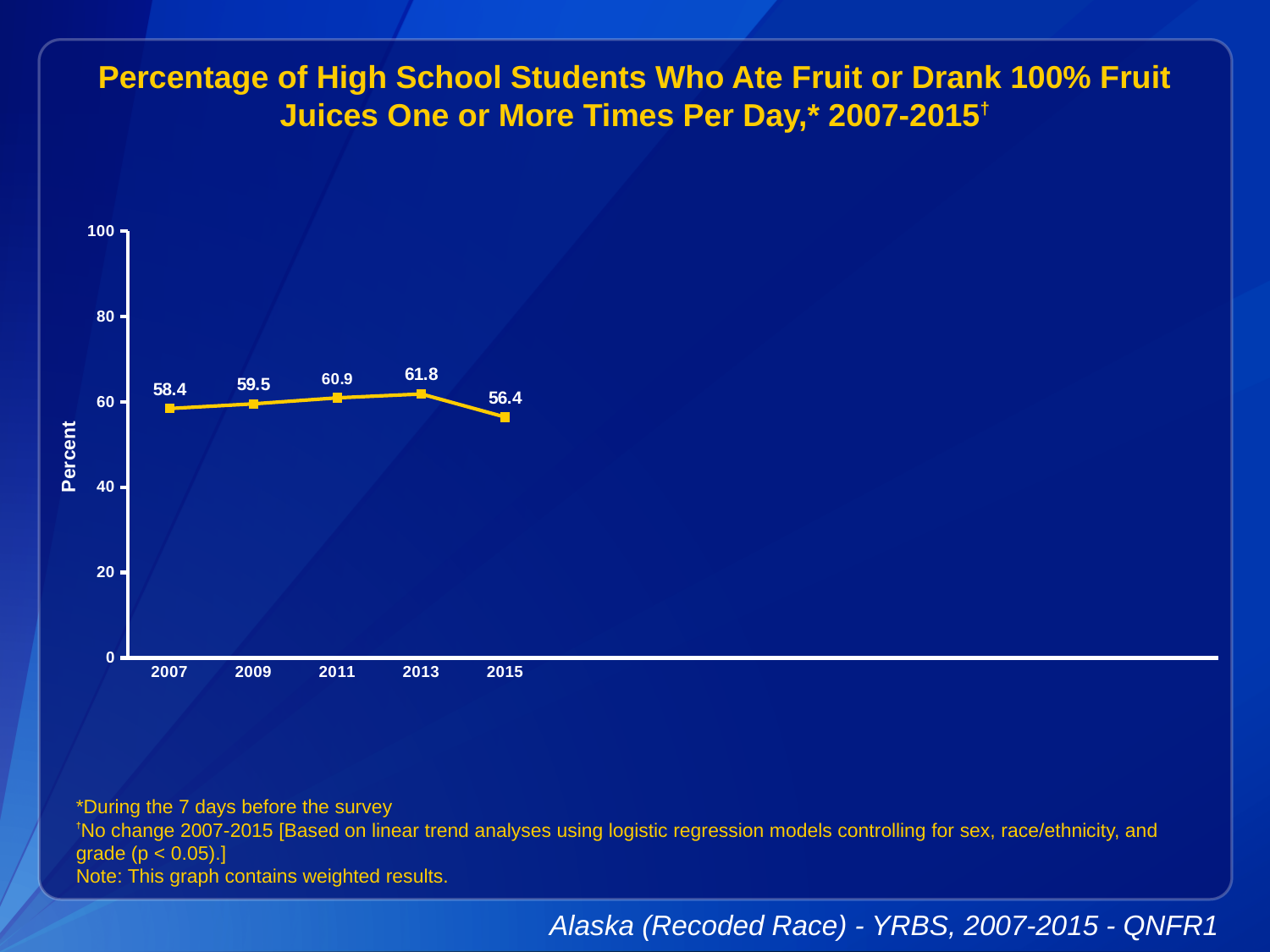
What is the value for 2015? 56.4 What is the difference between the values for 2013 and 2015? 5.4 Do the values rise or fall from 2007 to 2013? rise Which year has the highest value? 2013 How many years are plotted on the chart? 5 Which is larger, the value for 2009 or the value for 2011? 2011 What is the value for 2011? 60.9 What is the label of the y axis? Percent Which year has the lowest value? 2015 What is the value for 2007? 58.4 Is the value for 2013 greater or less than 80? less What kind of chart is shown on the slide? line chart